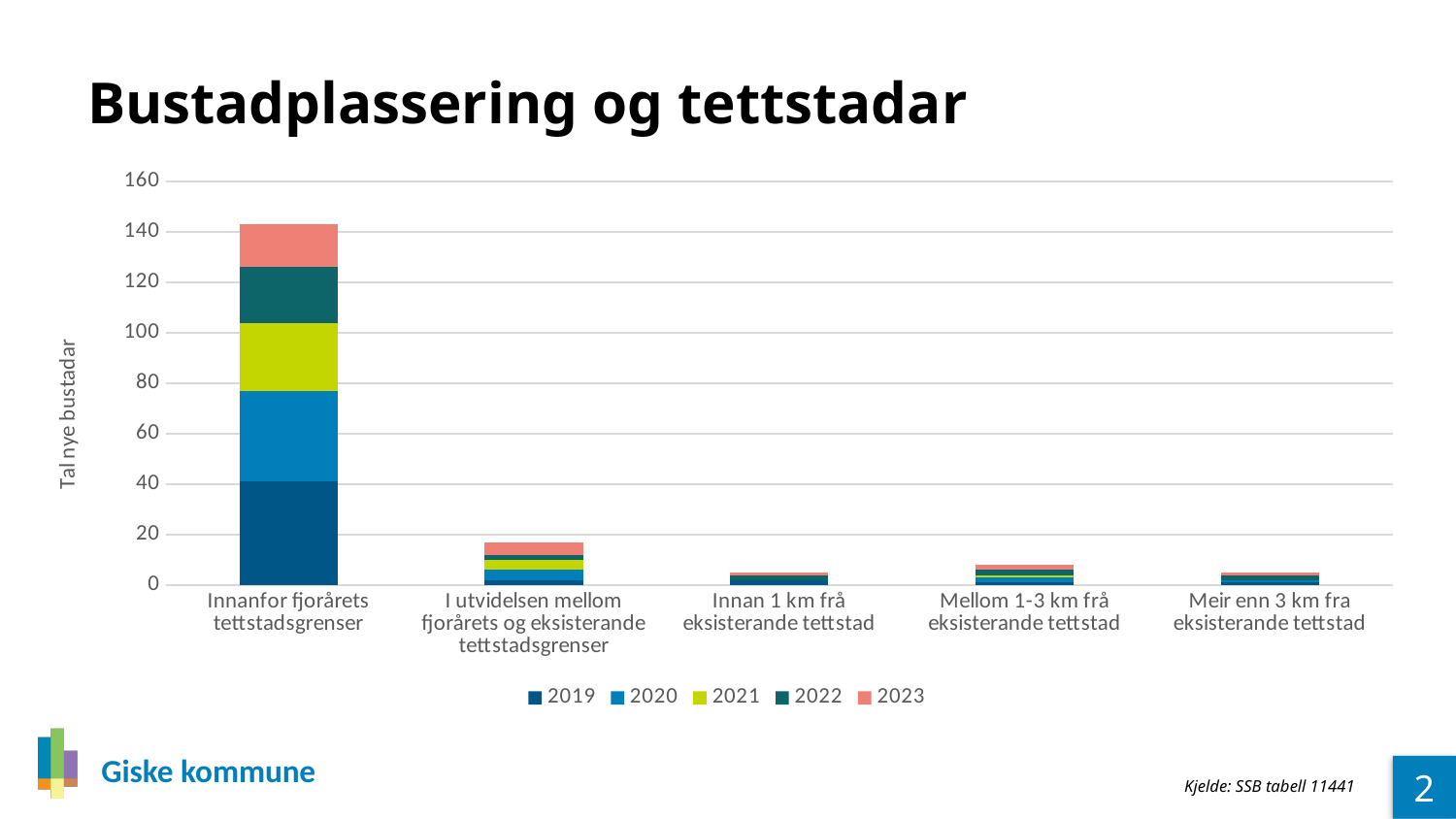
Which has a larger total: 'I utvidelsen mellom fjorårets og eksisterande tettstadsgrenser' or 'Mellom 1-3 km frå eksisterande tettstad'? I utvidelsen mellom fjorårets og eksisterande tettstadsgrenser Which has a larger total: 'Innanfor fjorårets tettstadsgrenser' or 'Innan 1 km frå eksisterande tettstad'? Innanfor fjorårets tettstadsgrenser Is the total for 'I utvidelsen mellom fjorårets og eksisterande tettstadsgrenser' greater or less than 20? less What is the title of the chart on the slide? Bustadplassering og tettstadar How many series does the legend list? 5 What is the label of the y axis? Tal nye bustadar Is the total for 'Mellom 1-3 km frå eksisterande tettstad' greater or less than 20? less Is the total for 'Innanfor fjorårets tettstadsgrenser' greater or less than 120? greater How many categories are shown on the x axis of the chart? 5 What kind of chart is shown on the slide? stacked bar chart Which category has the highest total number of new dwellings? Innanfor fjorårets tettstadsgrenser